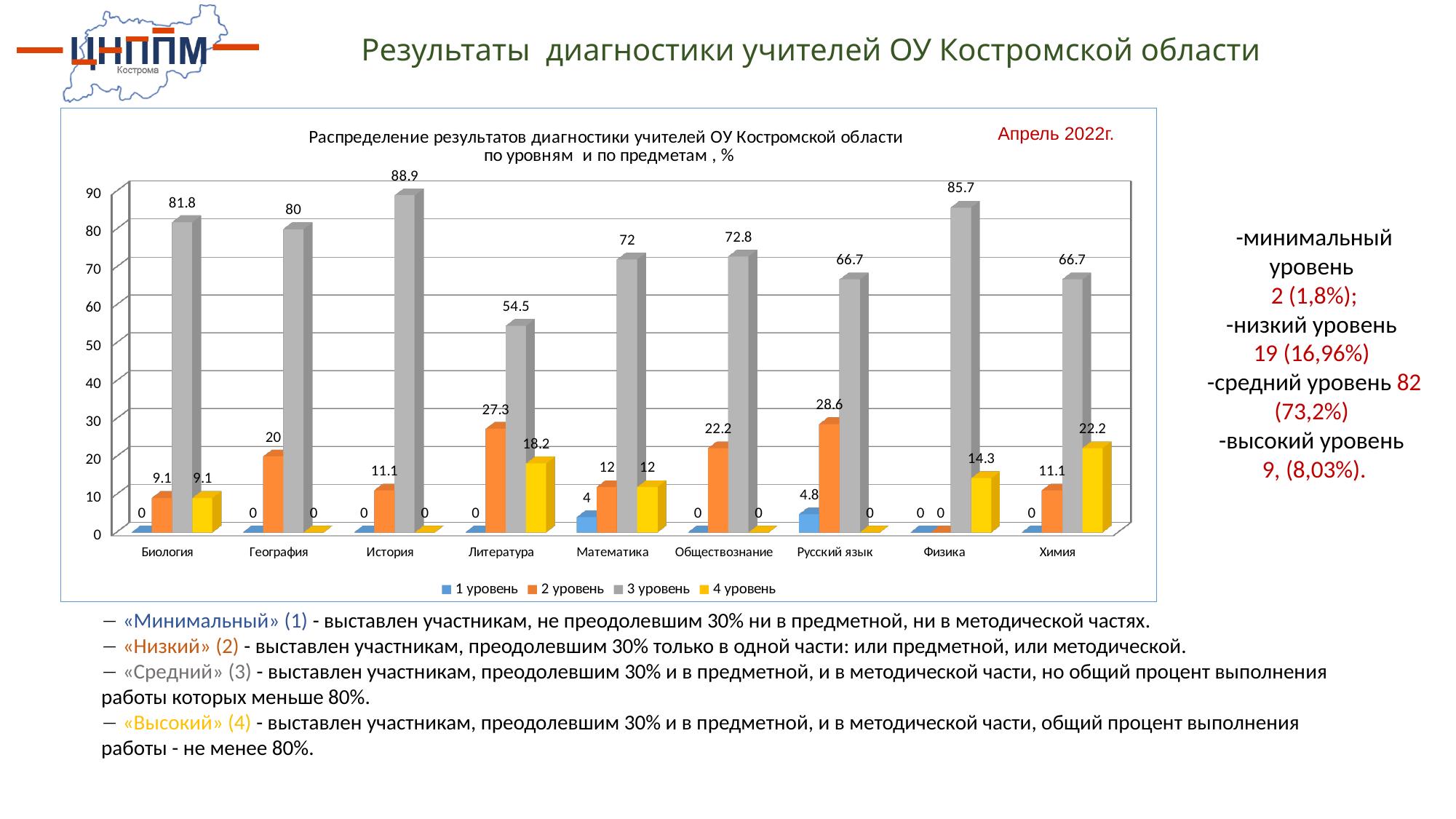
Which is larger: the «2 уровень» value for Литература or for Обществознание? Литература Which subject has the highest value for «3 уровень»? История What is the value of «3 уровень» for История? 88.9 How many subjects are shown on the x axis? 9 Is the «3 уровень» value for Физика greater or less than 80? greater What is the difference between the «3 уровень» values for Биология and Литература? 27.3 What is the value of «4 уровень» for Химия? 22.2 What kind of chart is shown on the slide? bar chart What is the value of «1 уровень» for Математика? 4 What is the value of «2 уровень» for Русский язык? 28.6 How many series does the legend list? 4 Which subject has the lowest value for «3 уровень»? Литература